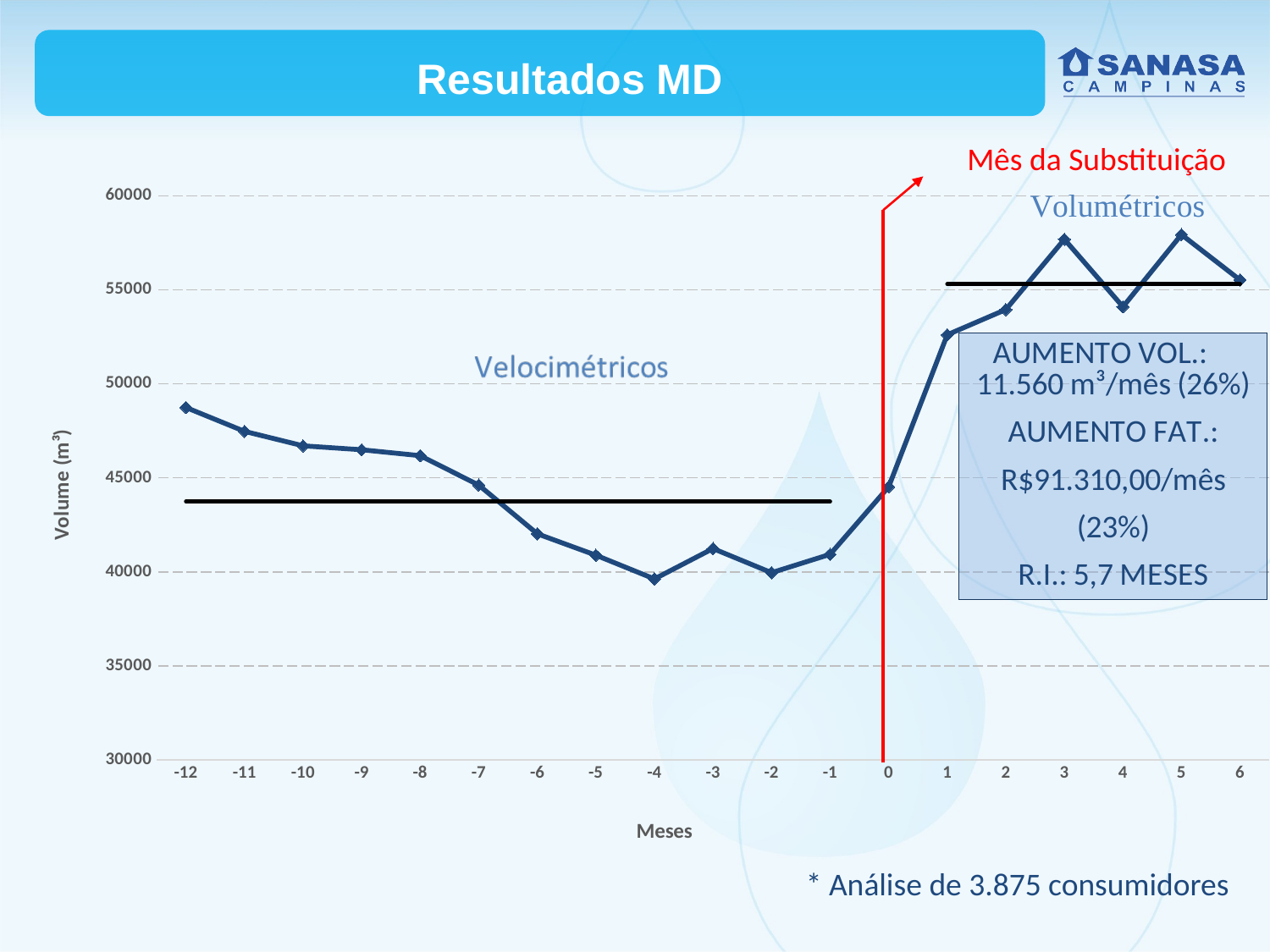
How many data points are plotted on the line (months -12 through 6)? 19 Is the value for month 3 greater or less than 55000? greater Which has the larger value, month 1 or month -1? month 1 Is the value for month 4 greater or less than 55000? less Is the value for month -4 greater or less than 40000? less Do the values rise or fall from month -12 to month -4? fall What is the title of the x axis? Meses Do the values rise or fall from month 0 to month 3? rise What kind of chart is shown on the slide? line chart